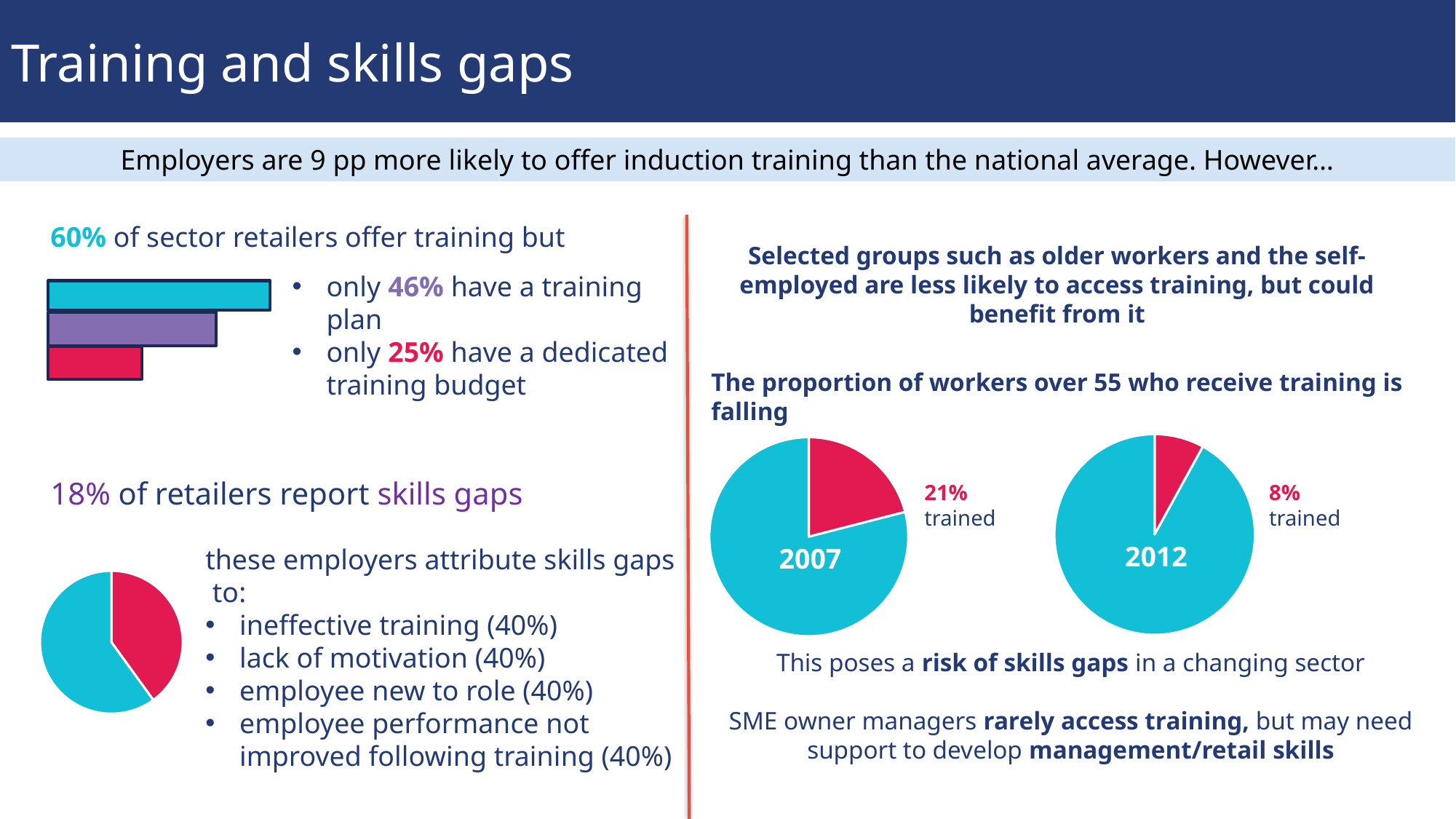
In the bar chart on the left, what is the difference between the share of retailers that offer training and the share with a dedicated training budget? 35 pp By how many percentage points did the share of workers over 55 receiving training fall between the 2007 and 2012 pie charts? 13 pp How many bars does the bar chart on the left have? 3 In the bar chart on the left, what percentage of retailers have a training plan (the purple bar)? 46% In the 2007 pie chart, what proportion of workers over 55 were trained? 21% In the 2012 pie chart, what proportion of workers over 55 were trained? 8% In the bar chart on the left, what percentage of retailers have a dedicated training budget (the red bar)? 25% What kind of chart is used on the left to show the 60%, 46% and 25% figures? Bar chart In the bar chart on the left, what percentage of sector retailers offer training (the longest, cyan bar)? 60% What kind of chart is used to show the proportion of workers over 55 who receive training in 2007 and 2012? Pie chart In the bar chart on the left, which bar is the shortest? Dedicated training budget (25%) Comparing the 2007 and 2012 pie charts, which year had the larger share of workers over 55 trained? 2007